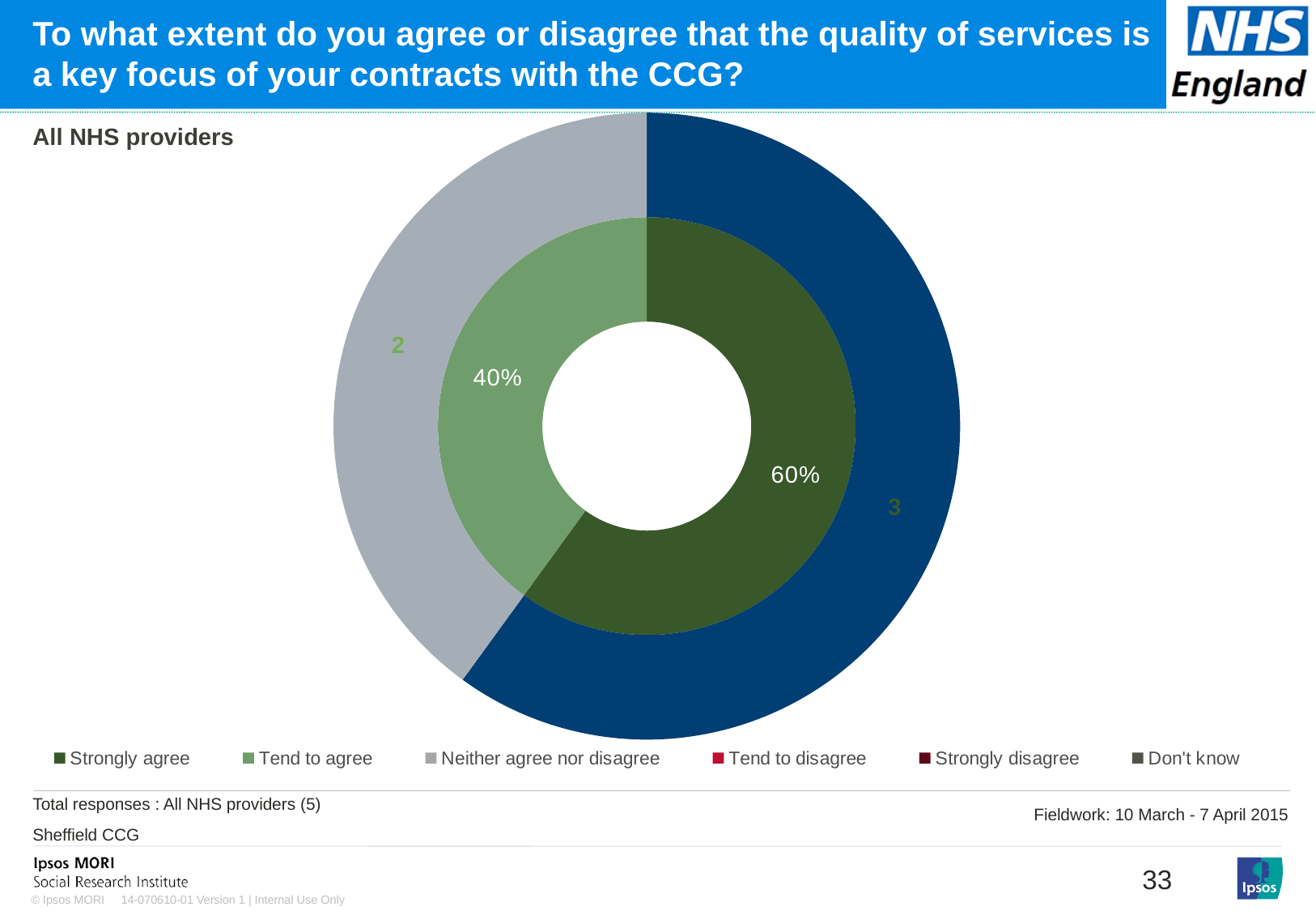
What is the difference in percentage points between Strongly agree (60%) and Tend to agree (40%)? 20 percentage points What group label appears above the chart at the top left? All NHS providers What number is printed on the dark blue segment of the outer ring? 3 How many entries does the legend list? 6 What percentage is shown for Strongly agree in the inner ring? 60% Which is larger, the share for Strongly agree or the share for Tend to agree? Strongly agree How many segments does the inner ring of the chart contain? 2 What kind of chart is shown on the slide? Pie (doughnut) chart What percentage is shown for Tend to agree in the inner ring? 40% What number is printed on the grey segment of the outer ring? 2 What is the total of the two numbers printed on the outer ring (3 and 2)? 5 Which response category has the largest share in the inner ring? Strongly agree